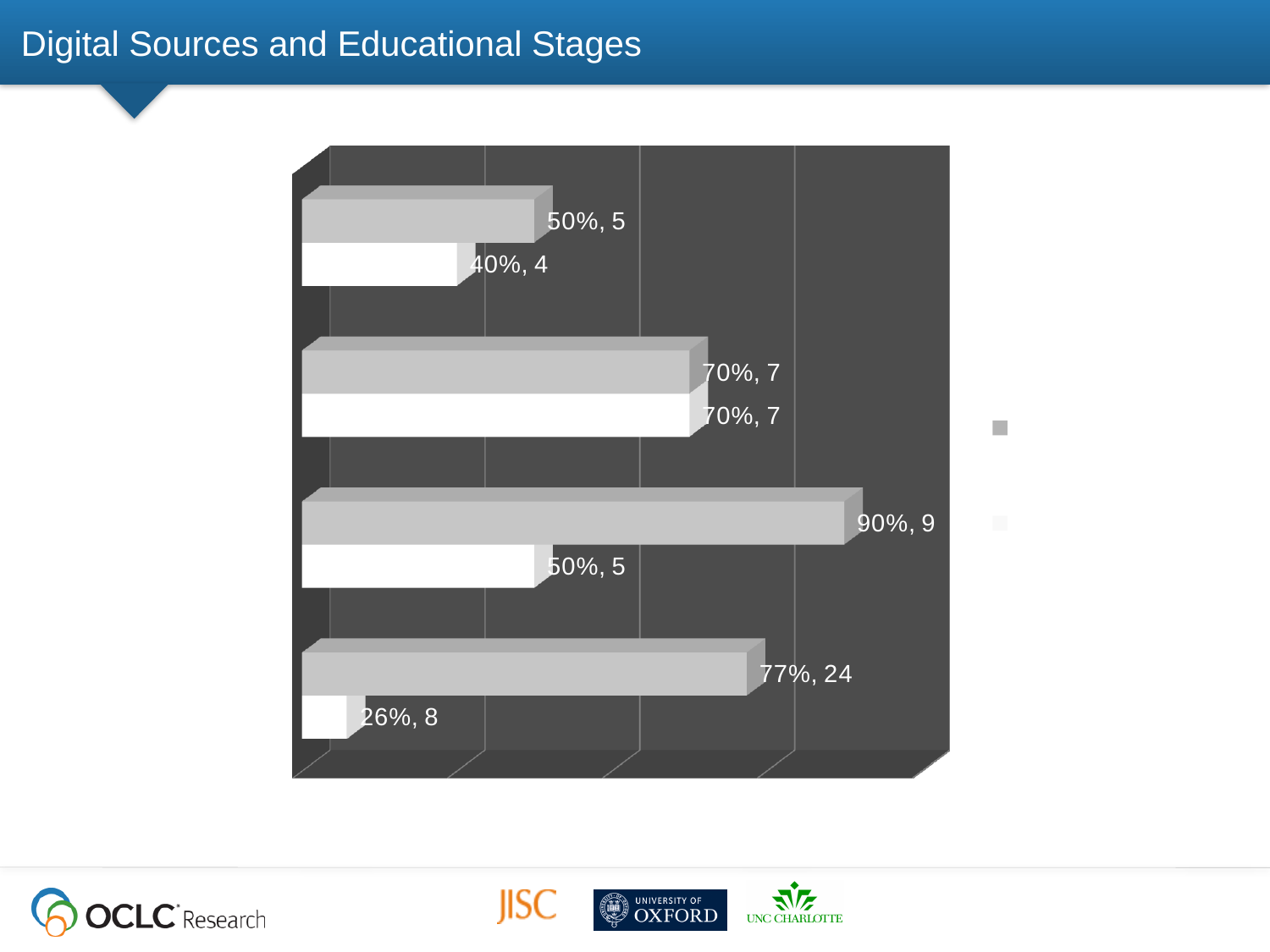
What is the lowest percentage shown on any bar in the chart? 26% What is the data label on the white bar in the bottom group? 26%, 8 What kind of chart is shown on the slide? bar chart In the second group from the top, which is larger, the grey bar or the white bar? They are equal (70%, 7) What is the data label on the grey bar in the topmost group? 50%, 5 What is the data label on the grey bar in the bottom group? 77%, 24 What is the title of the slide containing the chart? Digital Sources and Educational Stages Which bar has the highest percentage in the chart, and what is its label? The grey bar in the third group, 90%, 9 How many groups of bars are plotted in the chart? 4 In the third group from the top, what is the difference in percentage points between the grey bar (90%) and the white bar (50%)? 40 percentage points How many series does the legend list? 2 What is the data label on the white bar in the topmost group? 40%, 4